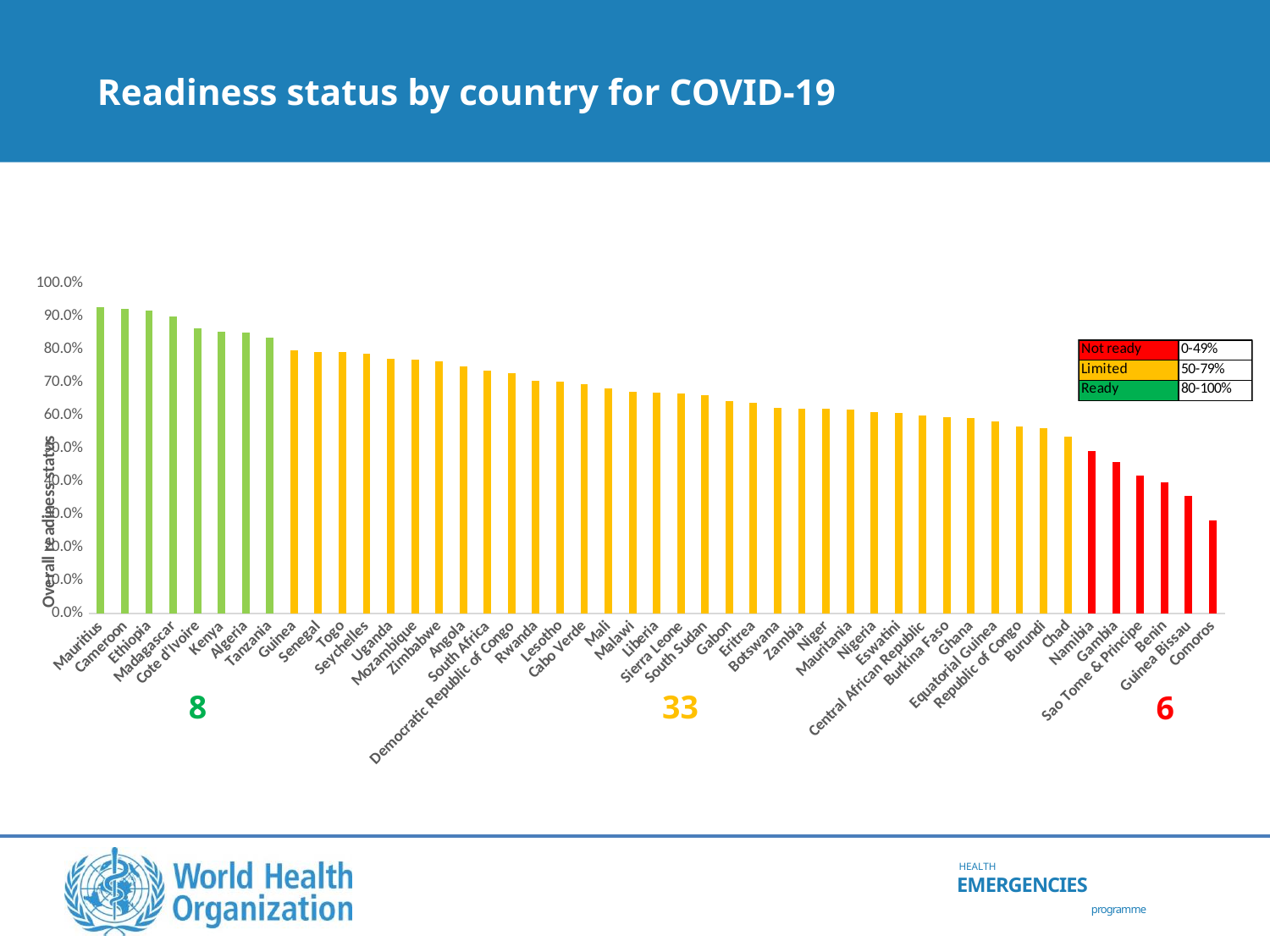
Is the value for Kenya greater or less than 80%? greater Do the values rise or fall from left to right along the x axis? fall Is the value for Comoros greater or less than 40%? less Which country has the lowest overall readiness status? Comoros Is the value for Gabon greater or less than 60%? greater Which has a higher readiness status, Kenya or Chad? Kenya According to the legend, what percentage range is classified as 'Limited'? 50-79% How many countries are shown in the 'Ready' (green) group? 8 What kind of chart is shown on the slide? bar chart Which country has the highest overall readiness status? Mauritius